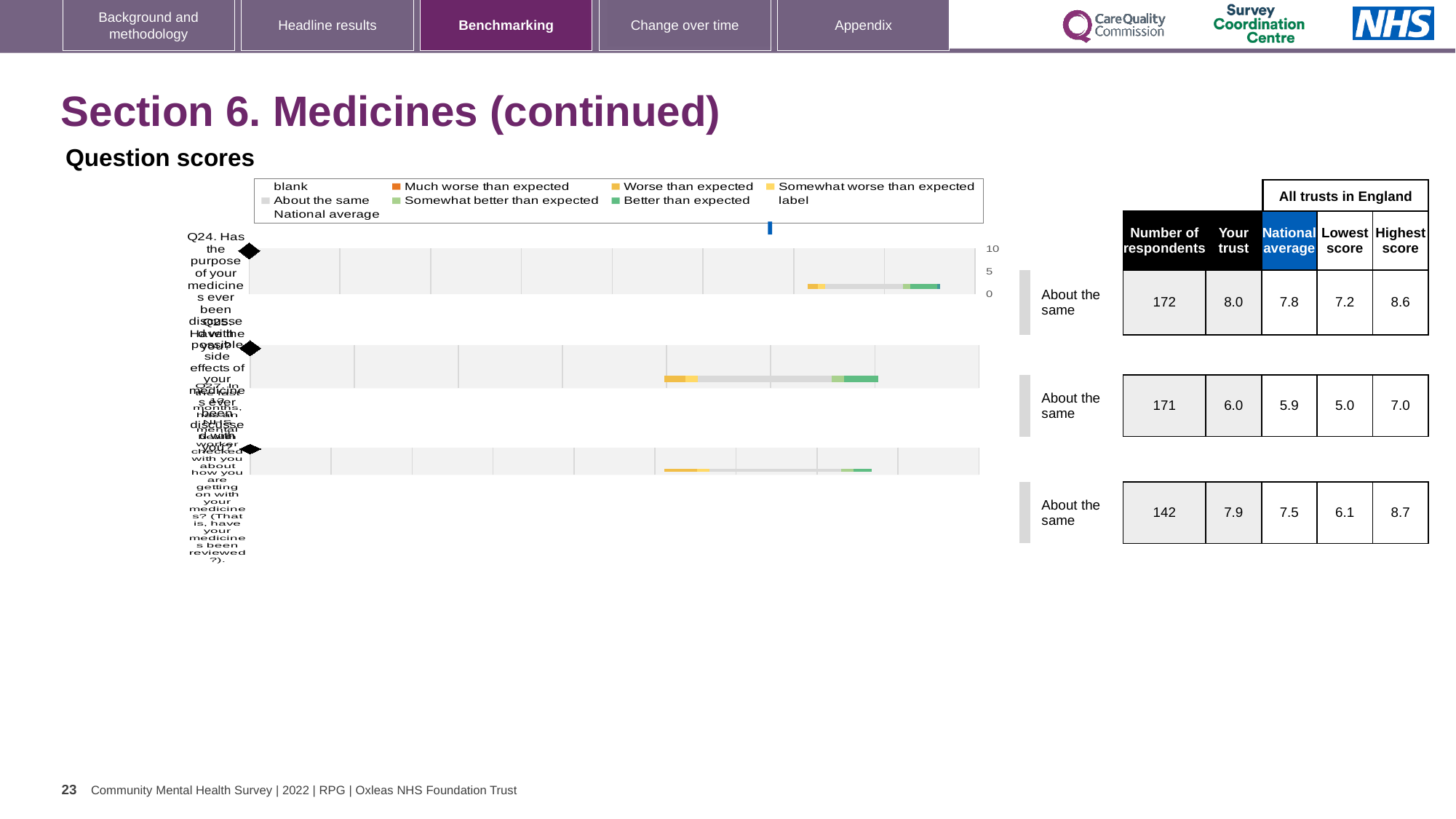
How many entries does the chart legend list? 9 What benchmark category is shown for each of the three rows? About the same What is the 'Your trust' score for the first row (Q24)? 8.0 What is the highest score across all trusts in England for the third row (Q27)? 8.7 How many question rows are plotted in the chart? 3 What is the number of respondents for the third row (Q27)? 142 What is the national average for the second row (Q25)? 5.9 Which row has the highest number of respondents? Q24 Is the 'Your trust' score for the first row (Q24) larger or smaller than the national average for that row? larger Which row has the lowest 'Your trust' score? Q25 What is the difference between the 'Your trust' score and the national average for the third row (Q27)? 0.4 What kind of chart is shown under 'Question scores'? bar chart